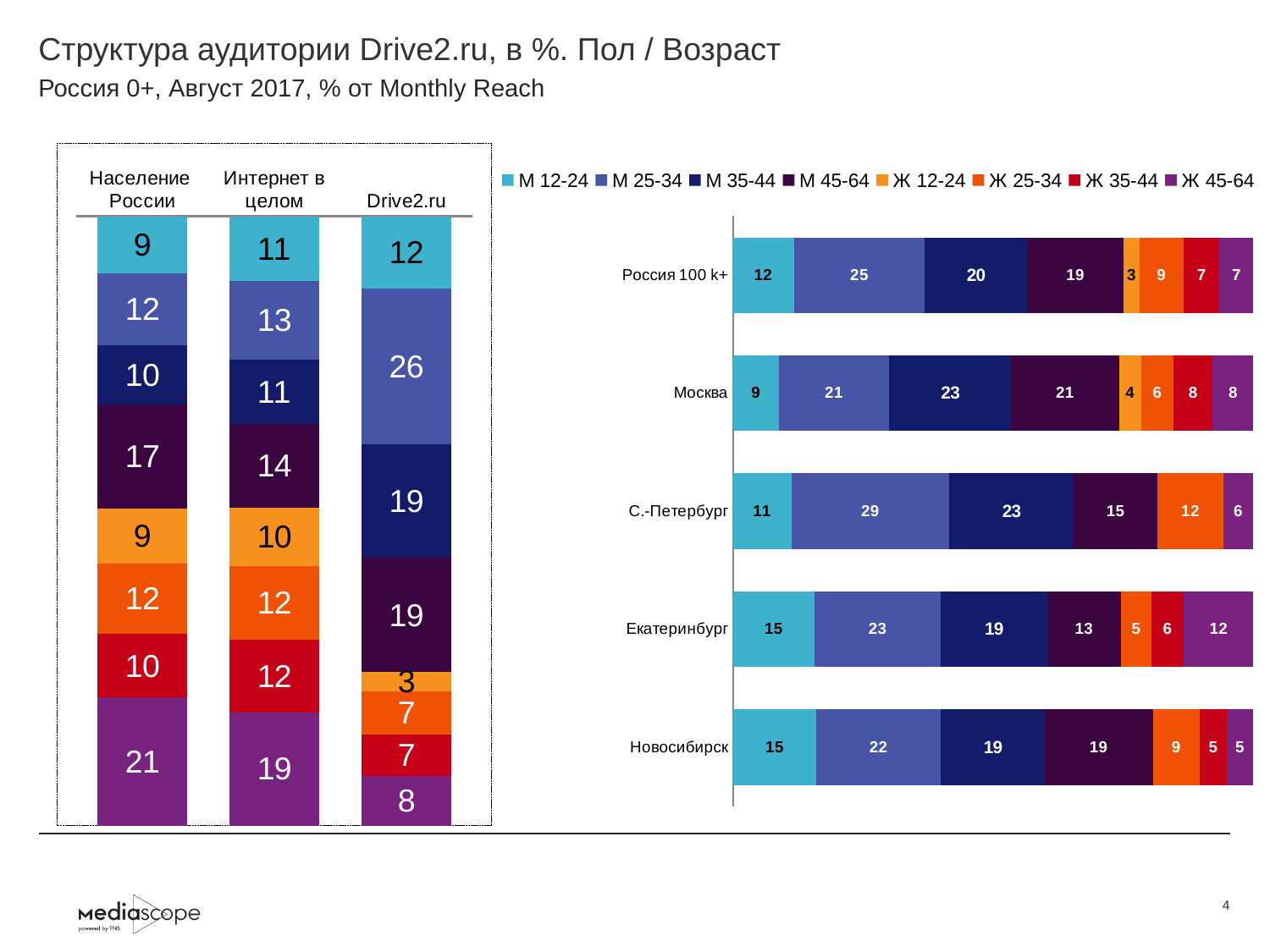
In the left stacked bar chart, what is the value of the М 25-34 segment for Drive2.ru? 26 How many categories (rows) are shown in the right horizontal bar chart? 5 In the left stacked bar chart, what is the value of the Ж 45-64 segment for Население России? 21 In the left stacked bar chart, what is the difference between the М 25-34 values for Drive2.ru and Население России? 14 What kind of chart is the chart on the right side of the slide? Stacked horizontal bar chart In the left stacked bar chart, what is the value of the М 45-64 segment for Интернет в целом? 14 How many series does the legend list? 8 In the left stacked bar chart, what is the total of the Drive2.ru bar? 101 In the right horizontal bar chart, what is the value of the М 35-44 segment for Москва? 23 In the right horizontal bar chart, which city has the highest М 12-24 value among Москва, С.-Петербург and Екатеринбург? Екатеринбург In the right horizontal bar chart, which is larger: the М 45-64 value for Москва or for С.-Петербург? Москва In the right horizontal bar chart, what is the value of the М 25-34 segment for С.-Петербург? 29